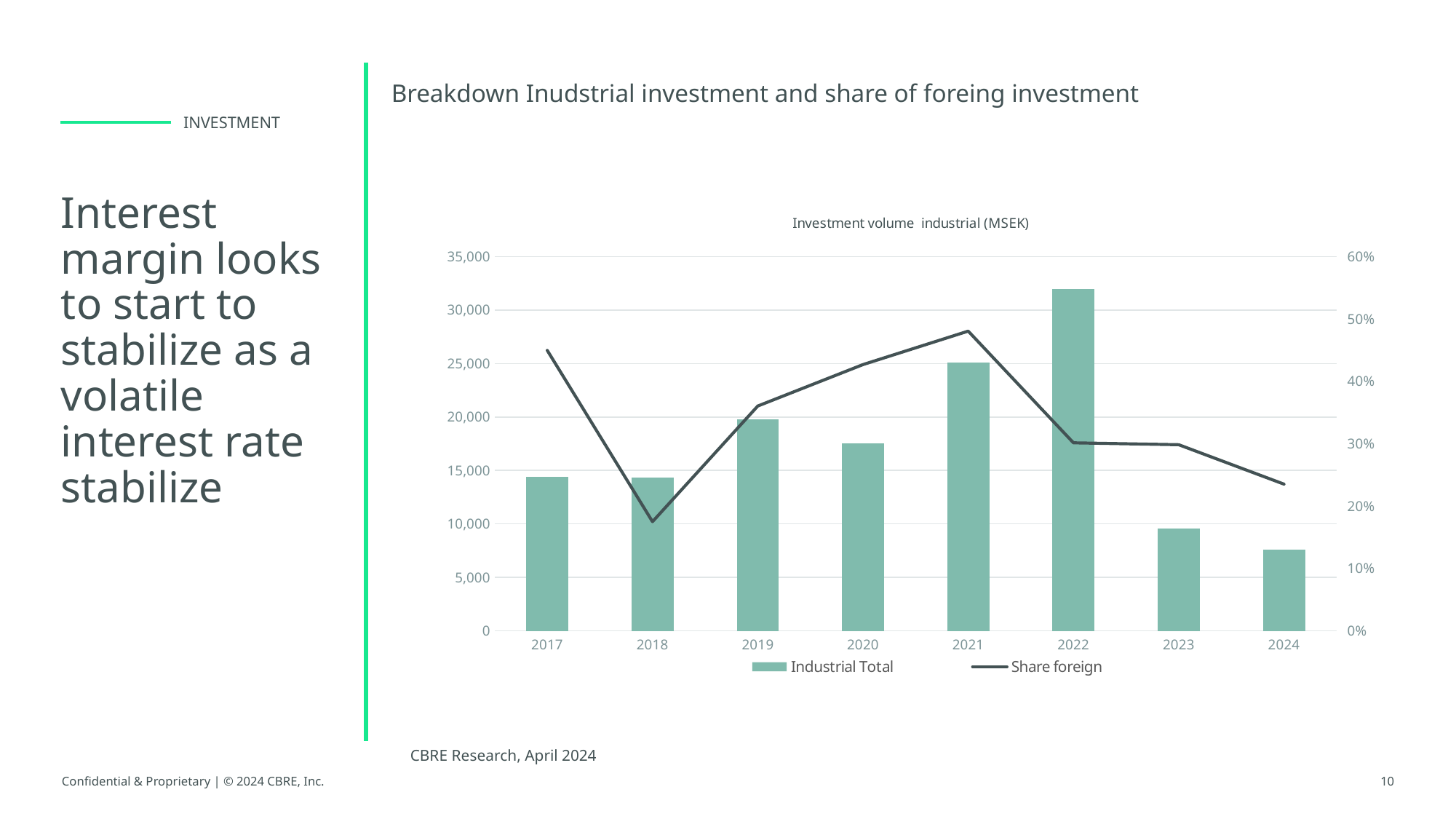
Which year has the larger Industrial Total, 2020 or 2021? 2021 Which year has the highest Industrial Total bar? 2022 Is the Industrial Total for 2022 greater or less than 30,000? greater Which year has the lowest Industrial Total bar? 2024 Is the Share foreign for 2018 greater or less than 20%? less In which year does the Share foreign line reach its lowest point? 2018 What is the title shown above the chart's plot area? Investment volume industrial (MSEK) Is the Industrial Total for 2023 greater or less than 10,000? less In which year does the Share foreign line reach its highest point? 2021 What kind of chart is shown on the slide? Combined bar and line chart How many years are shown on the x axis of the chart? 8 How many series does the chart legend list? 2